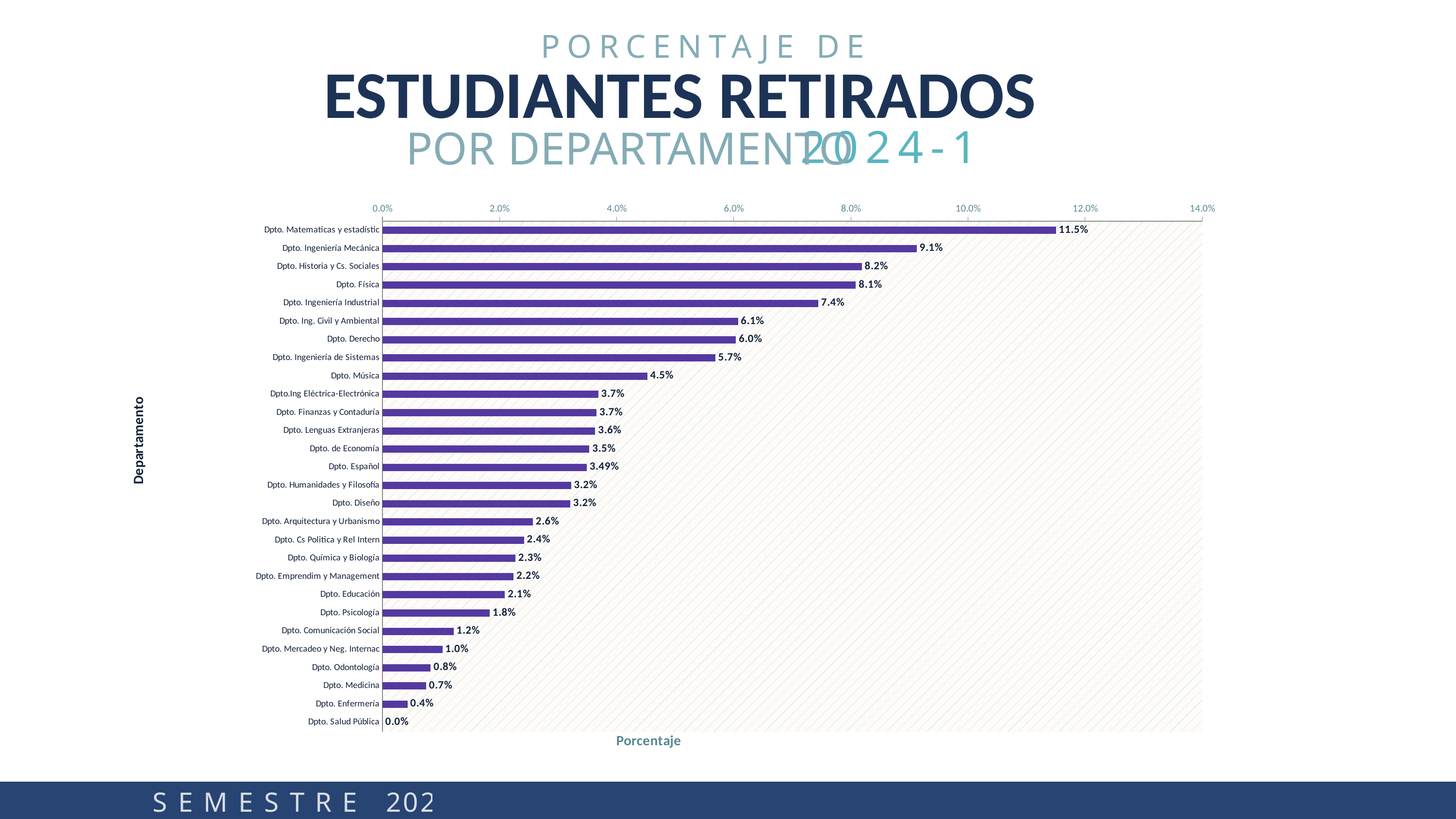
What is the value for Dpto. Psicología? 1.8% How many departments are shown in the chart? 28 What is the label of the horizontal axis? Porcentaje Which department has the highest percentage? Dpto. Matematicas y estadístic Which is larger, the value for Dpto. Derecho or the value for Dpto. Ingeniería de Sistemas? Dpto. Derecho What kind of chart is shown on the slide? bar chart What is the value for Dpto. Música? 4.5% Is the value for Dpto. Ingeniería Industrial greater or less than 8.0%? less Which department has the lowest percentage? Dpto. Salud Pública What is the difference between the values for Dpto. Matematicas y estadístic and Dpto. Ingeniería Mecánica? 2.4% What is the value for Dpto. Español? 3.49% What is the value for Dpto. Ingeniería Mecánica? 9.1%